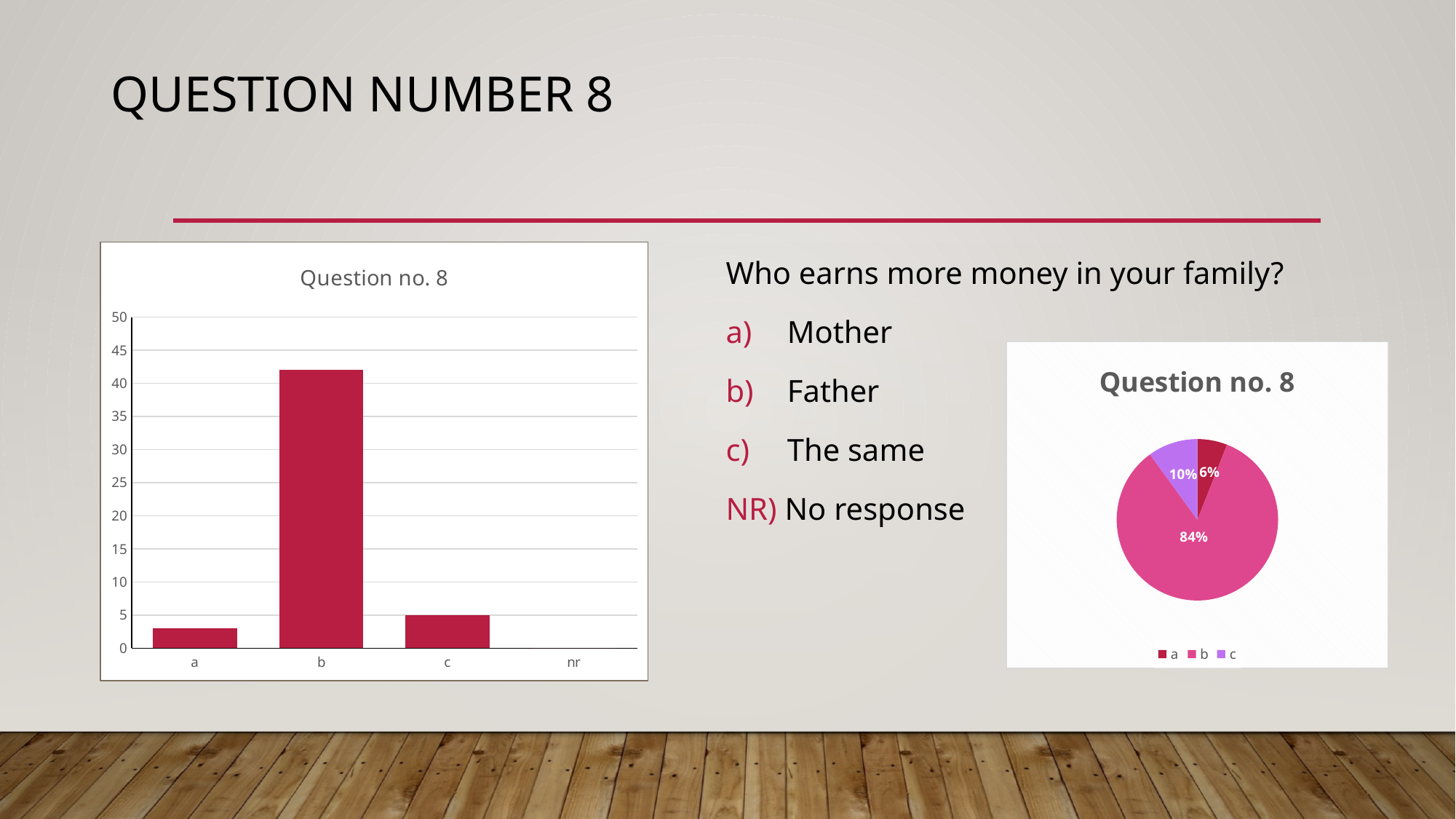
In the bar chart on the left, is the value for a greater or less than 5? less In the bar chart on the left, which is larger, the value for a or the value for c? c How many entries does the legend of the pie chart on the right list? 3 What kind of chart is the chart on the right of the slide? pie chart In the pie chart on the right, what share does slice a have? 6% In the pie chart on the right, what is the difference between the shares of b and c? 74% In the pie chart on the right, what share does slice b have? 84% What kind of chart is the chart on the left of the slide? bar chart In the bar chart on the left, is the value for c greater or less than 10? less In the bar chart on the left, is the value for b greater or less than 35? greater In the bar chart on the left, how many categories are shown on the x axis? 4 In the bar chart on the left, which category has the highest value? b